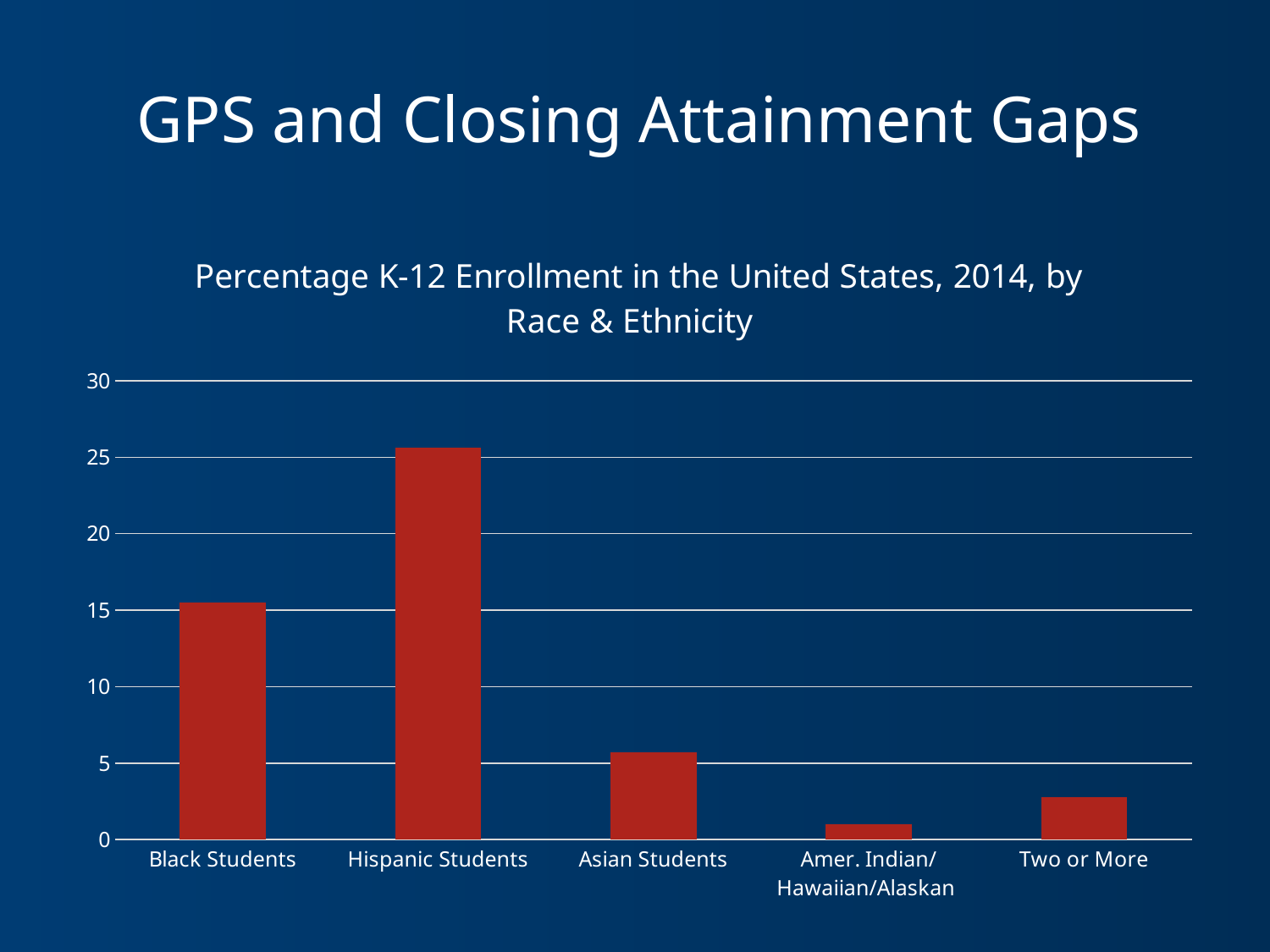
Which is larger, the value for Two or More or the value for Amer. Indian/Hawaiian/Alaskan? Two or More Is the value for Black Students greater or less than 20? less Which is larger, the value for Black Students or the value for Asian Students? Black Students Which category has the highest value in the chart? Hispanic Students Is the value for Asian Students greater or less than 10? less How many categories are shown on the x axis of the chart? 5 What is the title of the chart? Percentage K-12 Enrollment in the United States, 2014, by Race & Ethnicity Is the value for Amer. Indian/Hawaiian/Alaskan greater or less than 5? less Which category has the lowest value in the chart? Amer. Indian/Hawaiian/Alaskan What kind of chart is shown on the slide? Bar chart